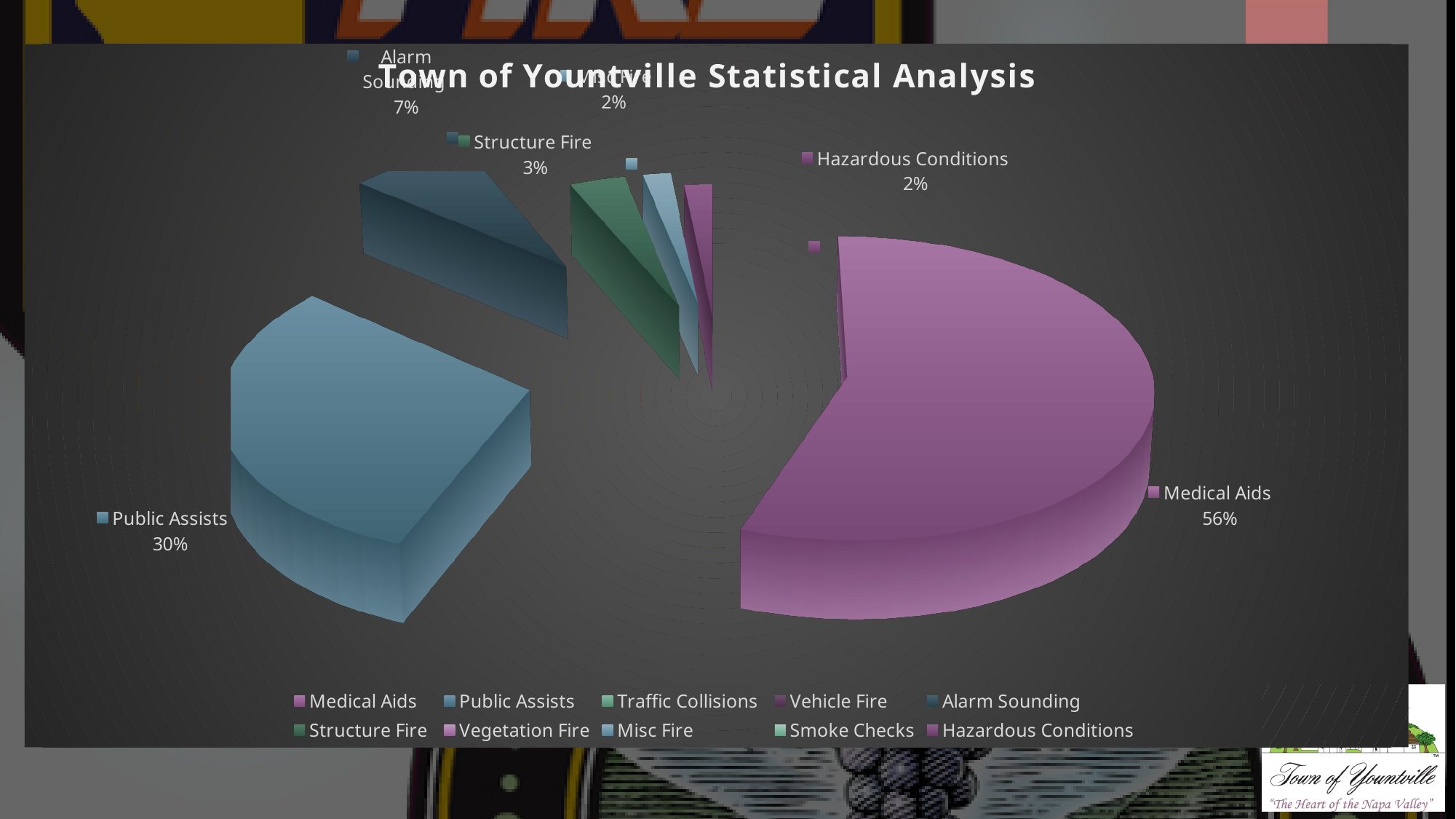
What percentage is shown for Public Assists? 30% What is the title of the chart? Town of Yountville Statistical Analysis What kind of chart is shown on the slide? Pie chart How many percentage points larger is the Medical Aids share than the Public Assists share? 26 percentage points What percentage is labelled for Hazardous Conditions? 2% What percentage of the pie does Medical Aids account for? 56% What percentage is shown for Structure Fire? 3% What percentage is labelled for Alarm Sounding? 7% Which is larger, the share for Public Assists or the share for Alarm Sounding? Public Assists Which category has the largest share of the pie? Medical Aids How many categories does the legend list? 10 Which is larger, the share for Structure Fire or the share for Hazardous Conditions? Structure Fire